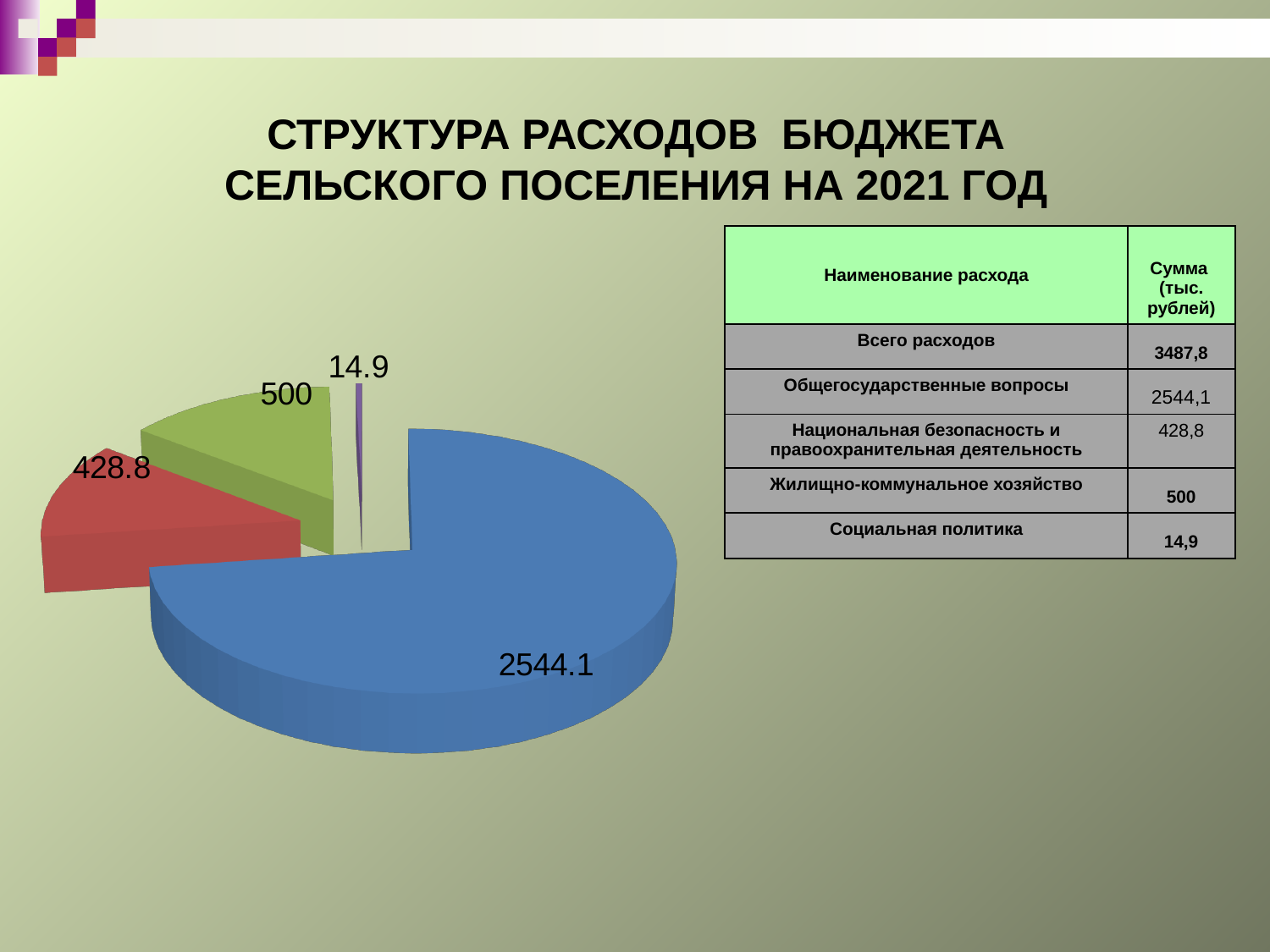
Which slice is larger in the pie chart, the green one or the red one? the green one (500) What value is labelled on the green slice of the pie chart? 500 What kind of chart is shown on the slide? pie chart What value is labelled on the red slice of the pie chart? 428.8 What is the value of the largest slice in the pie chart? 2544.1 What value is labelled on the purple slice of the pie chart? 14.9 What is the total of all the slice values labelled on the pie chart? 3487.8 What is the value of the smallest slice in the pie chart? 14.9 What is the difference between the green slice (500) and the red slice (428.8) in the pie chart? 71.2 What value is labelled on the blue slice of the pie chart? 2544.1 What is the title of the slide containing the pie chart? СТРУКТУРА РАСХОДОВ БЮДЖЕТА СЕЛЬСКОГО ПОСЕЛЕНИЯ НА 2021 ГОД How many slices does the pie chart have? 4